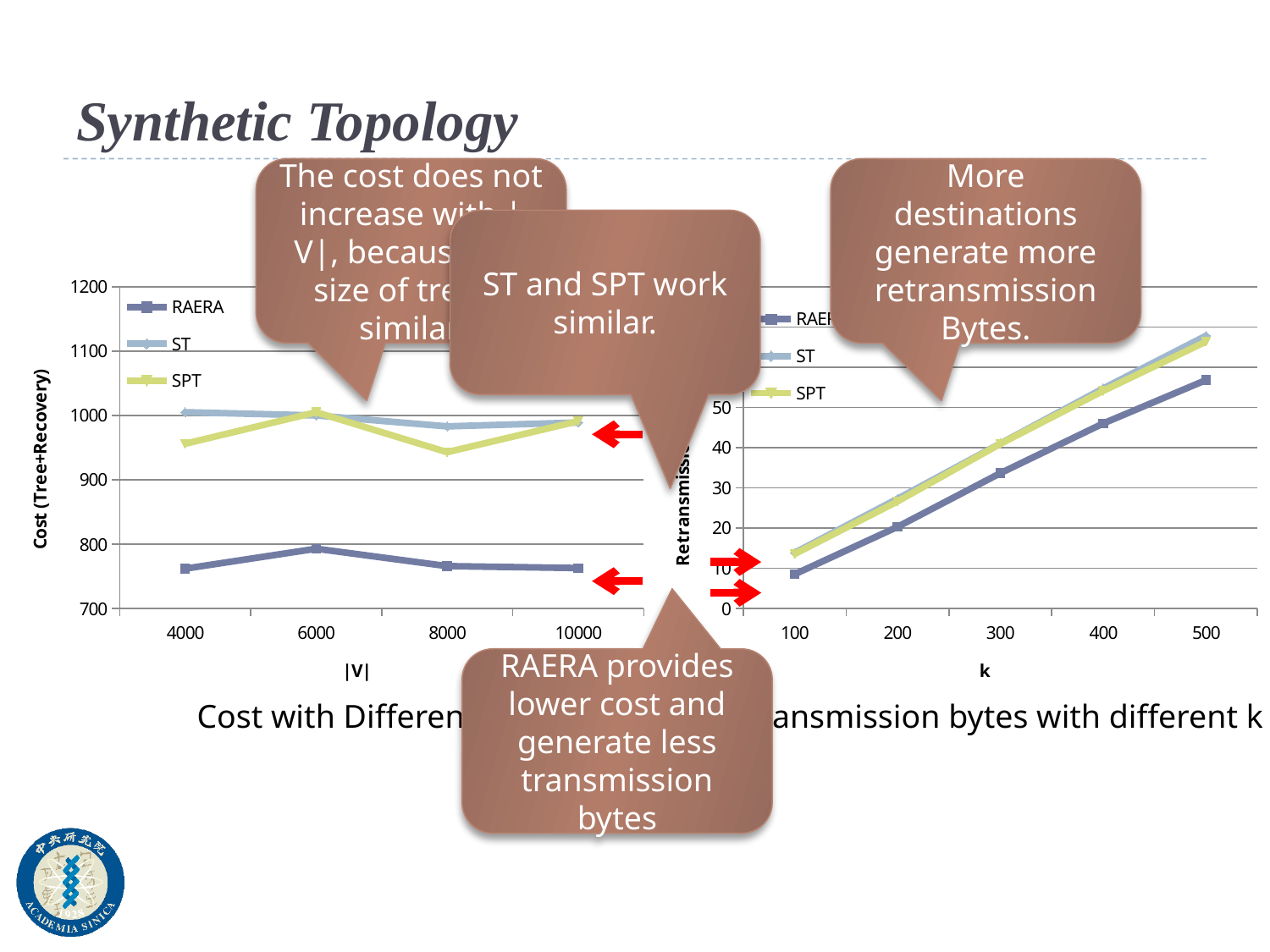
How many series does the legend of the left chart list? 3 In the left chart, is the RAERA value at |V| = 4000 greater or less than 800? less What kind of chart is the left chart (Cost vs |V|)? line chart How many k values are plotted on the x axis of the right chart? 5 In the right chart, at k = 500, which is larger: ST or RAERA? ST In the left chart, at |V| = 4000, which is larger: ST or RAERA? ST In the right chart, is the SPT value at k = 200 greater or less than 20? greater How many |V| values are plotted on the x axis of the left chart? 4 In the left chart, which series has the lowest cost across all |V| values? RAERA In the left chart, is the SPT value at |V| = 8000 greater or less than 1000? less In the right chart, do the retransmission bytes rise or fall as k increases? rise